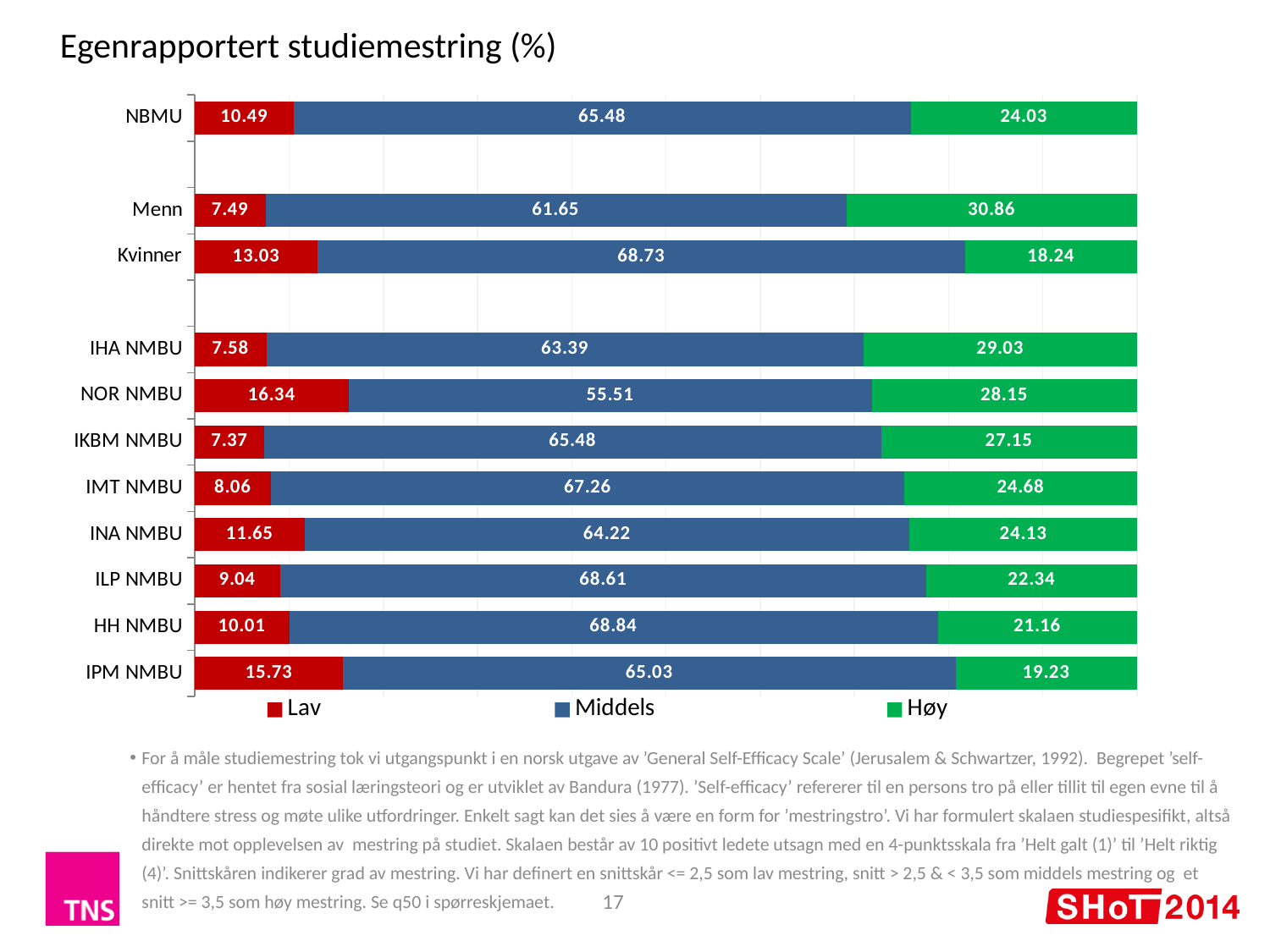
What is the Lav value for NOR NMBU? 16.34 What kind of chart is shown on the slide? Stacked bar chart Which category has the highest Høy value? Menn How many series does the legend list? 3 Which category has the lowest Lav value? IKBM NMBU What is the Middels value for Kvinner? 68.73 What is the title of the chart? Egenrapportert studiemestring (%) What is the difference between the Høy values for Menn and Kvinner? 12.62 What is the Høy value for Menn? 30.86 Which is larger, the Lav value for IPM NMBU or the Lav value for NOR NMBU? NOR NMBU How many categories are shown on the chart? 11 What is the total of the stacked bar for IHA NMBU? 100